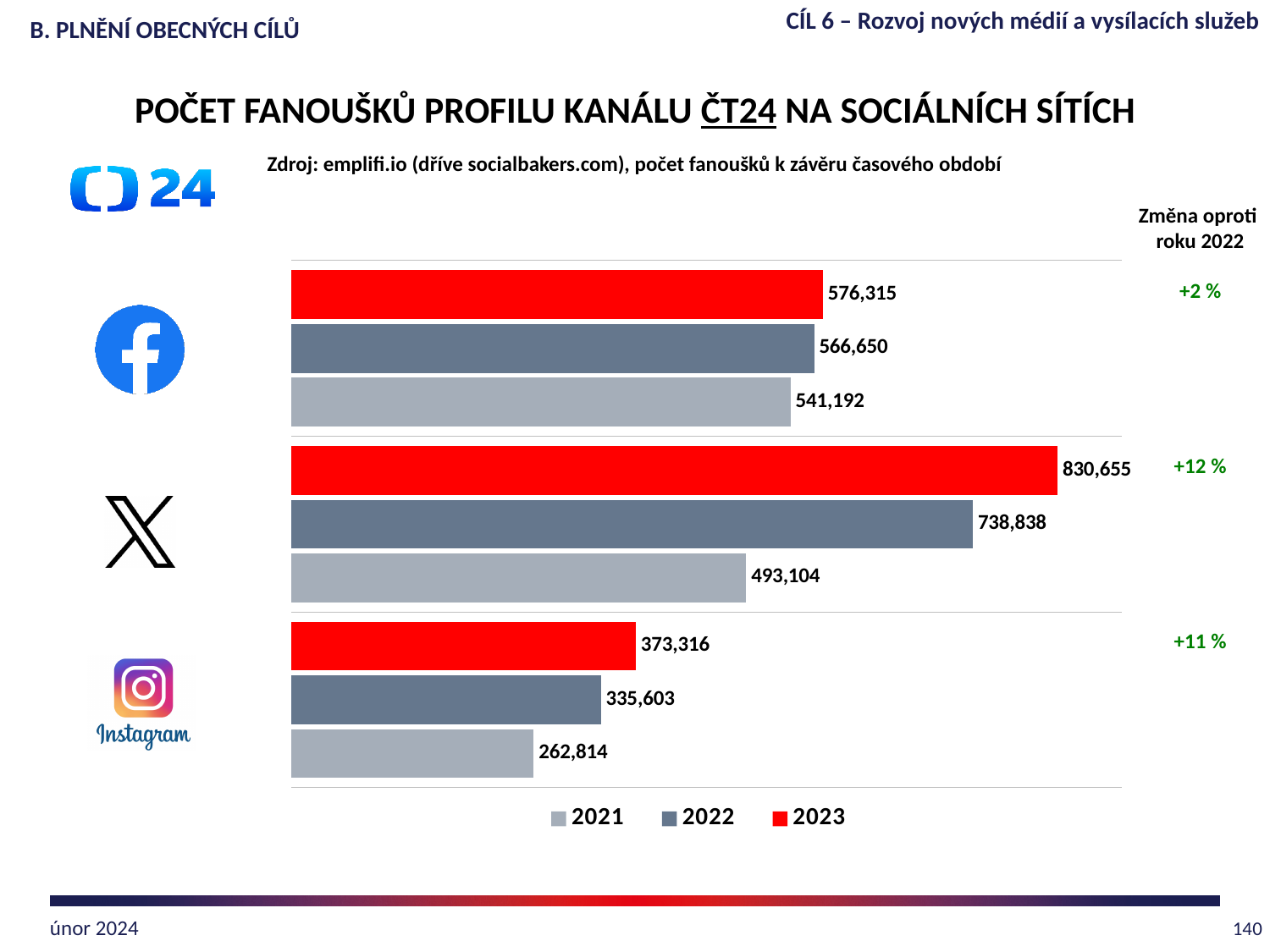
Which is larger: the Facebook fan count in 2021 or the X fan count in 2021? Facebook fan count in 2021 What is the number of ČT24 fans on Facebook in 2023? 576,315 Which social network had the lowest number of ČT24 fans in 2021? Instagram Which colour represents the 2023 series in the legend? red Did the number of ČT24 fans on Instagram rise or fall from 2021 to 2023? rise What is the number of ČT24 fans on Instagram in 2021? 262,814 What is the number of ČT24 fans on X in 2022? 738,838 How many series does the legend list? 3 What is the percentage change compared to 2022 shown for X? +12 % What kind of chart is shown on the slide? bar chart Which social network had the highest number of ČT24 fans in 2023? X What is the difference between the 2023 and 2022 fan counts on X? 91,817